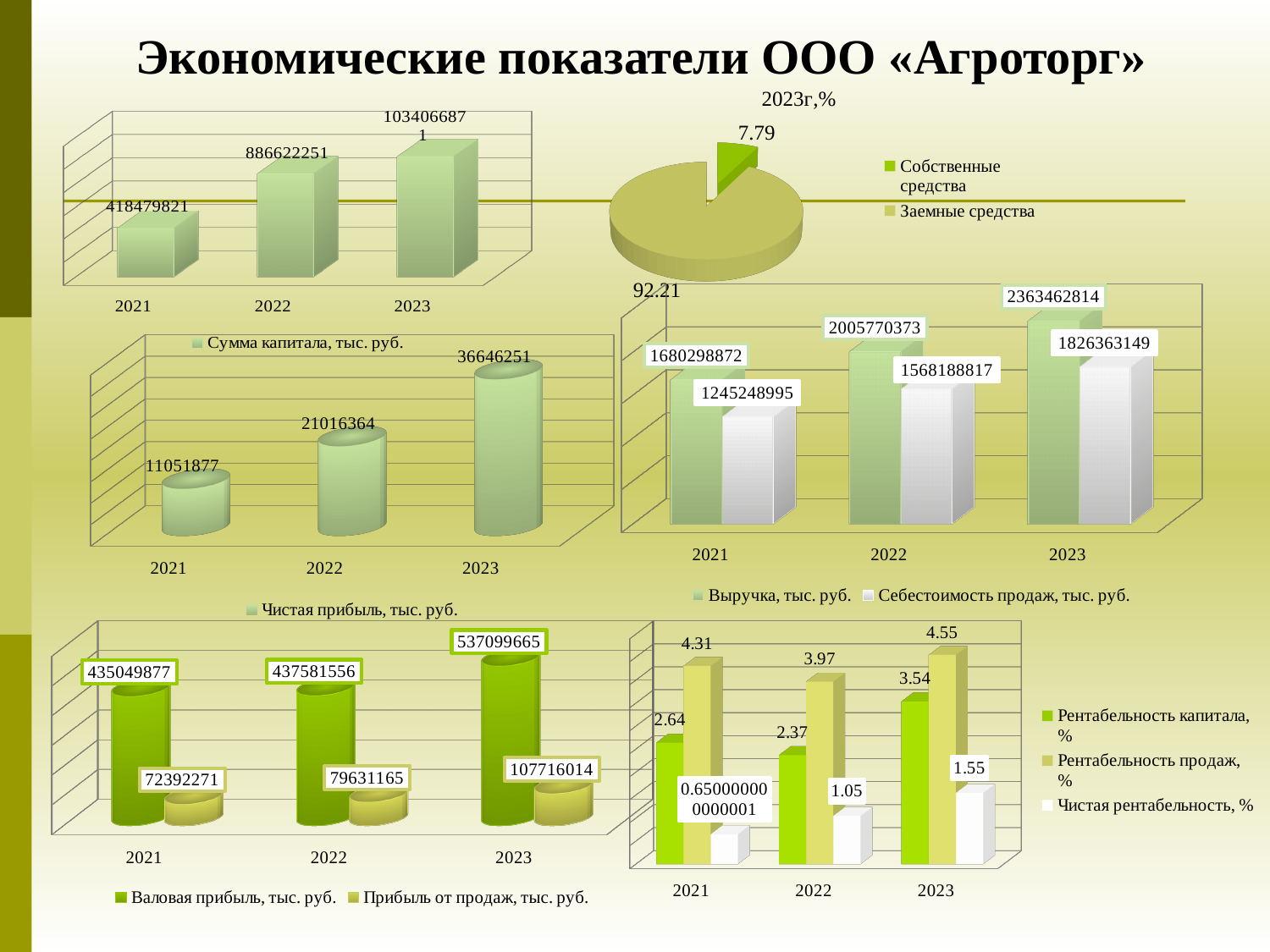
In the pie chart titled "2023г,%", what share is shown for Собственные средства? 7.79 In the bottom-right chart, what is the value of Рентабельность продаж, % for 2023? 4.55 In the middle-right chart, what is the difference between Выручка and Себестоимость продаж for 2023? 537099665 In the middle-left cylinder chart, what is the value for 2023? 36646251 In the bottom-left chart, which is larger for 2022: Валовая прибыль or Прибыль от продаж? Валовая прибыль In the pie chart titled "2023г,%", how many slices are there? 2 In the bottom-left chart, what is the value of Прибыль от продаж, тыс. руб. for 2021? 72392271 In the middle-left cylinder chart, do the values rise or fall from 2021 to 2023? rise In the top-left bar chart, which year has the lowest value? 2021 In the top-left bar chart, what is the value for 2022? 886622251 In the middle-right chart, what is the value of Выручка, тыс. руб. for 2022? 2005770373 How many series does the legend of the bottom-right chart list? 3